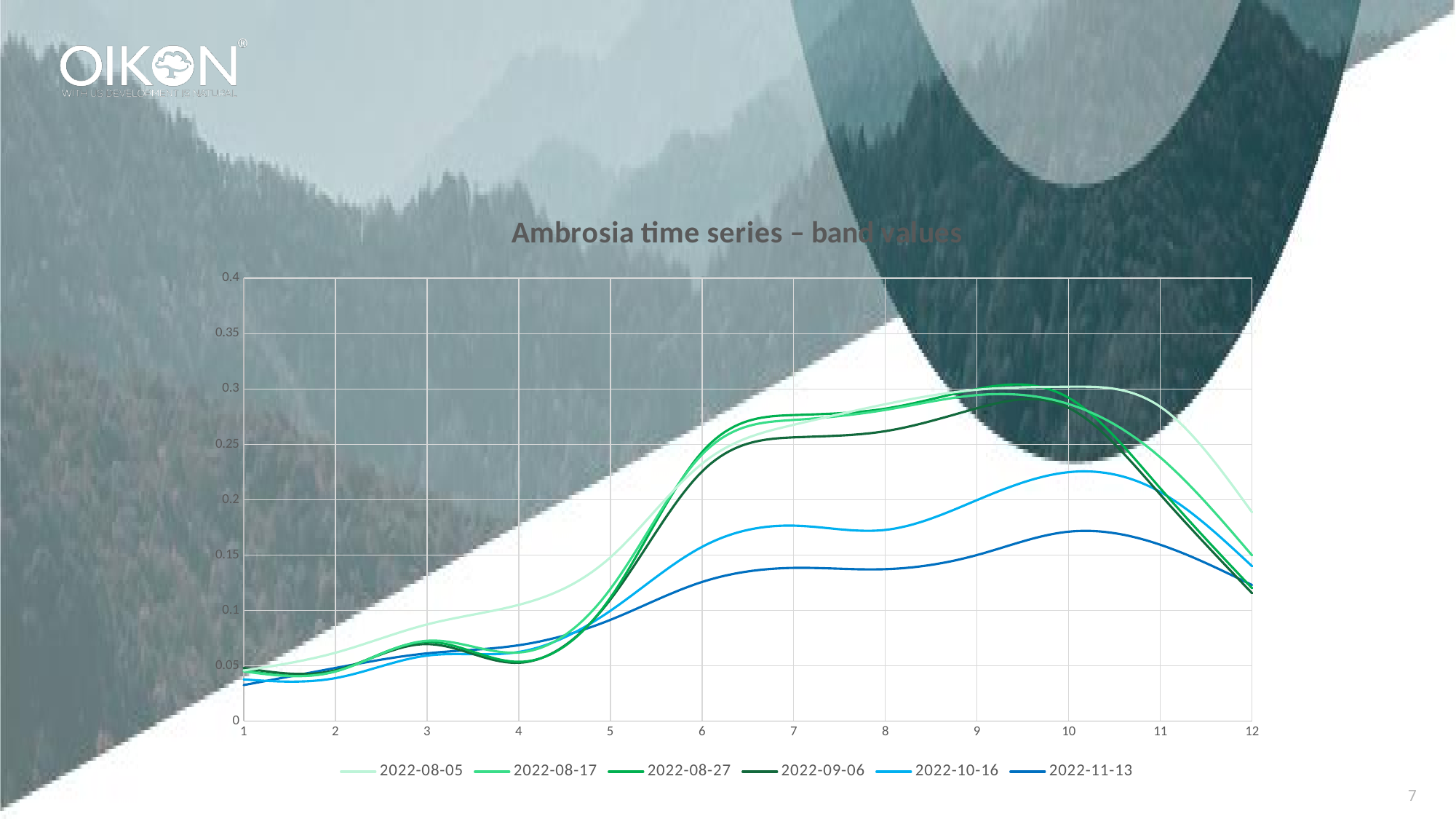
Is the value for 2022-11-13 at x = 1 greater or less than 0.05? less Is the value for 2022-11-13 at x = 10 greater or less than 0.2? less At x = 10, which series has the higher value, 2022-10-16 or 2022-11-13? 2022-10-16 Which series has the lowest value at x = 7? 2022-11-13 Is the value for 2022-08-05 at x = 10 greater or less than 0.25? greater What is the title of the chart? Ambrosia time series – band values What kind of chart is shown on the slide? line chart Does the 2022-08-05 series rise or fall between x = 10 and x = 12? fall How many points are marked along the x axis? 12 How many series does the legend list? 6